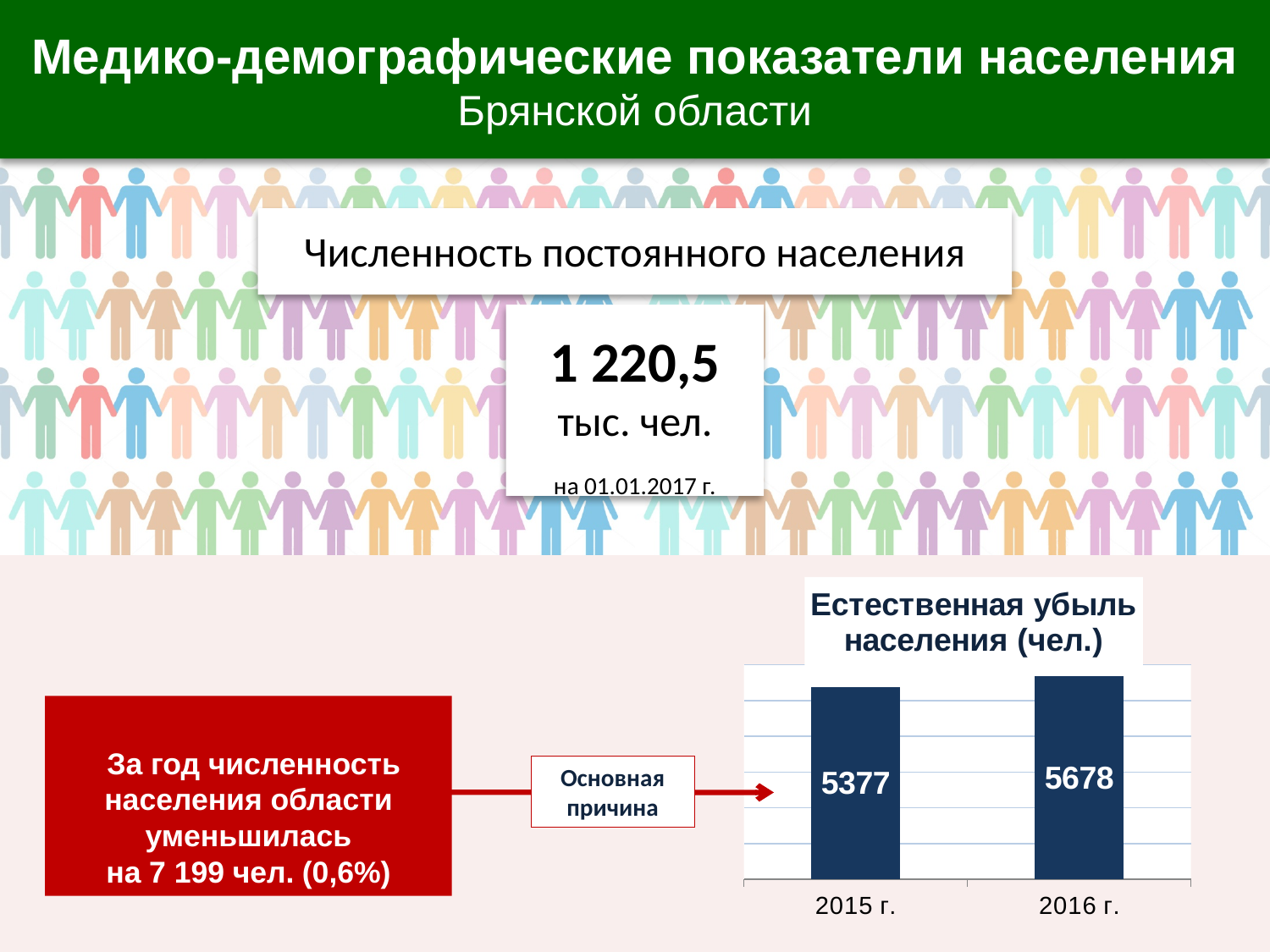
Which year has the higher value in the chart? 2016 г. How many bars are shown in the chart? 2 What is the value for 2015 г. in the chart? 5377 What kind of chart is shown on the slide? bar chart What colour are the bars in the chart? dark blue What is the difference between the values for 2016 г. and 2015 г. in the chart? 301 What is the value for 2016 г. in the chart? 5678 What is the title of the chart? Естественная убыль населения (чел.) Do the values in the chart rise or fall from 2015 г. to 2016 г.? rise Which year has the lower value in the chart? 2015 г. Is the value for 2016 г. larger or smaller than the value for 2015 г.? larger